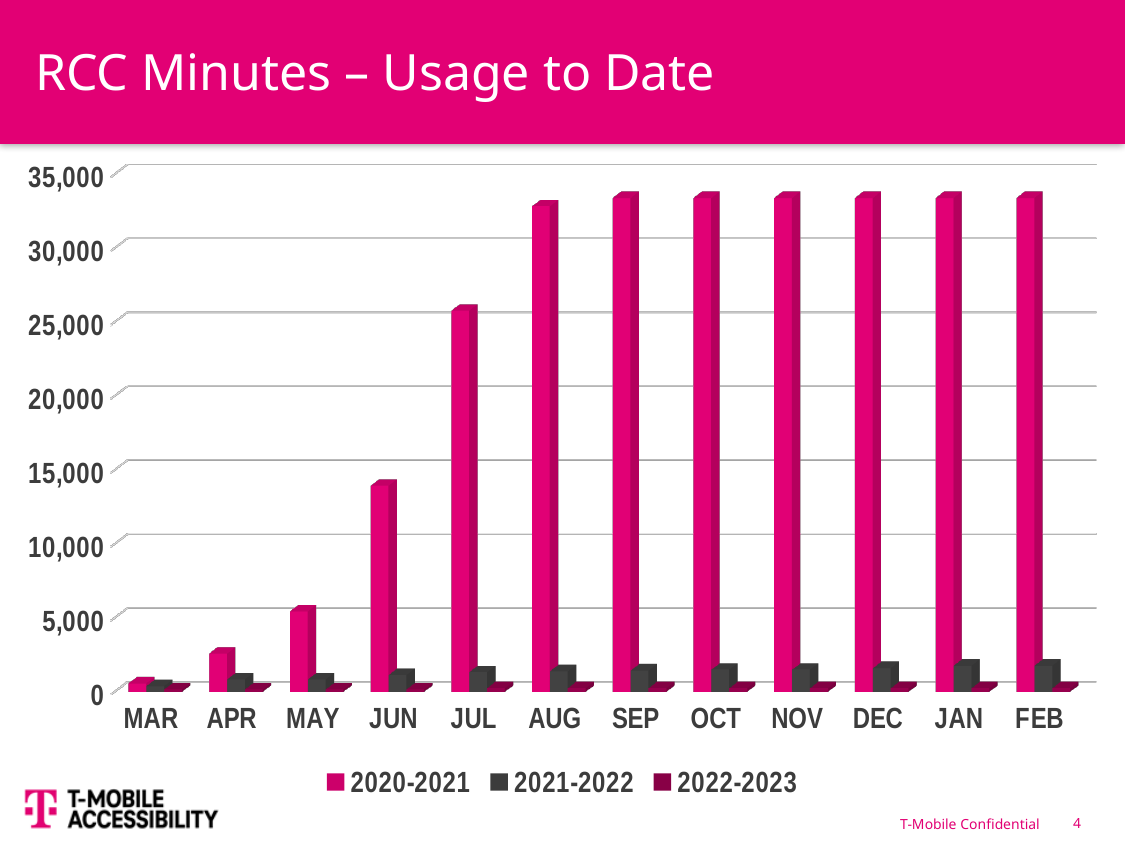
How many series does the legend list? 3 Is the 2021-2022 value for DEC greater or less than 5,000? less Does the 2020-2021 series rise or fall from MAR to JUL? rise Is the 2020-2021 value for JUN greater or less than 15,000? less How many months are shown along the x axis? 12 What kind of chart is shown on the slide? bar chart Which series is shown in the tallest magenta bars? 2020-2021 Is the 2020-2021 value for AUG greater or less than 30,000? greater Which month has the lowest value for the 2020-2021 series? MAR What is the title of the slide's chart? RCC Minutes – Usage to Date